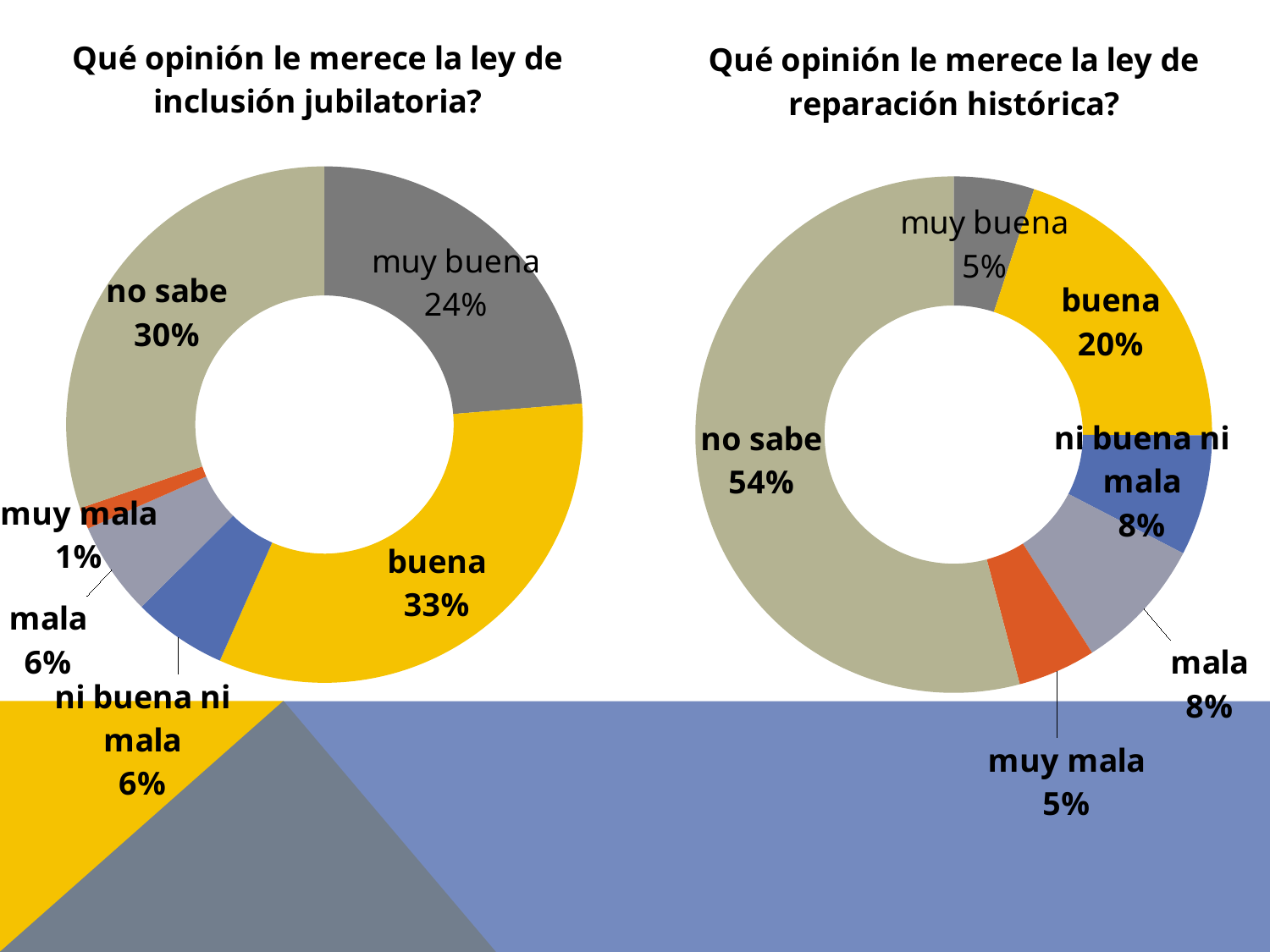
In the chart 'Qué opinión le merece la ley de inclusión jubilatoria?', which category has the largest share? buena In the chart 'Qué opinión le merece la ley de reparación histórica?', which category has the largest share? no sabe In the chart 'Qué opinión le merece la ley de inclusión jubilatoria?', what is the value for 'muy mala'? 1% In the chart 'Qué opinión le merece la ley de inclusión jubilatoria?', which category has the smallest share? muy mala In the chart 'Qué opinión le merece la ley de inclusión jubilatoria?', what is the value for 'buena'? 33% In the chart 'Qué opinión le merece la ley de reparación histórica?', which is larger, 'buena' or 'mala'? buena In the chart 'Qué opinión le merece la ley de reparación histórica?', what is the value for 'no sabe'? 54% What kind of chart is used on the left side of the slide? Doughnut chart In the chart 'Qué opinión le merece la ley de inclusión jubilatoria?', how many categories are shown? 6 In the chart 'Qué opinión le merece la ley de reparación histórica?', what is the value for 'buena'? 20% In the chart 'Qué opinión le merece la ley de reparación histórica?', what is the difference between 'no sabe' and 'buena'? 34% In the chart 'Qué opinión le merece la ley de inclusión jubilatoria?', what is the difference between 'no sabe' and 'muy buena'? 6%